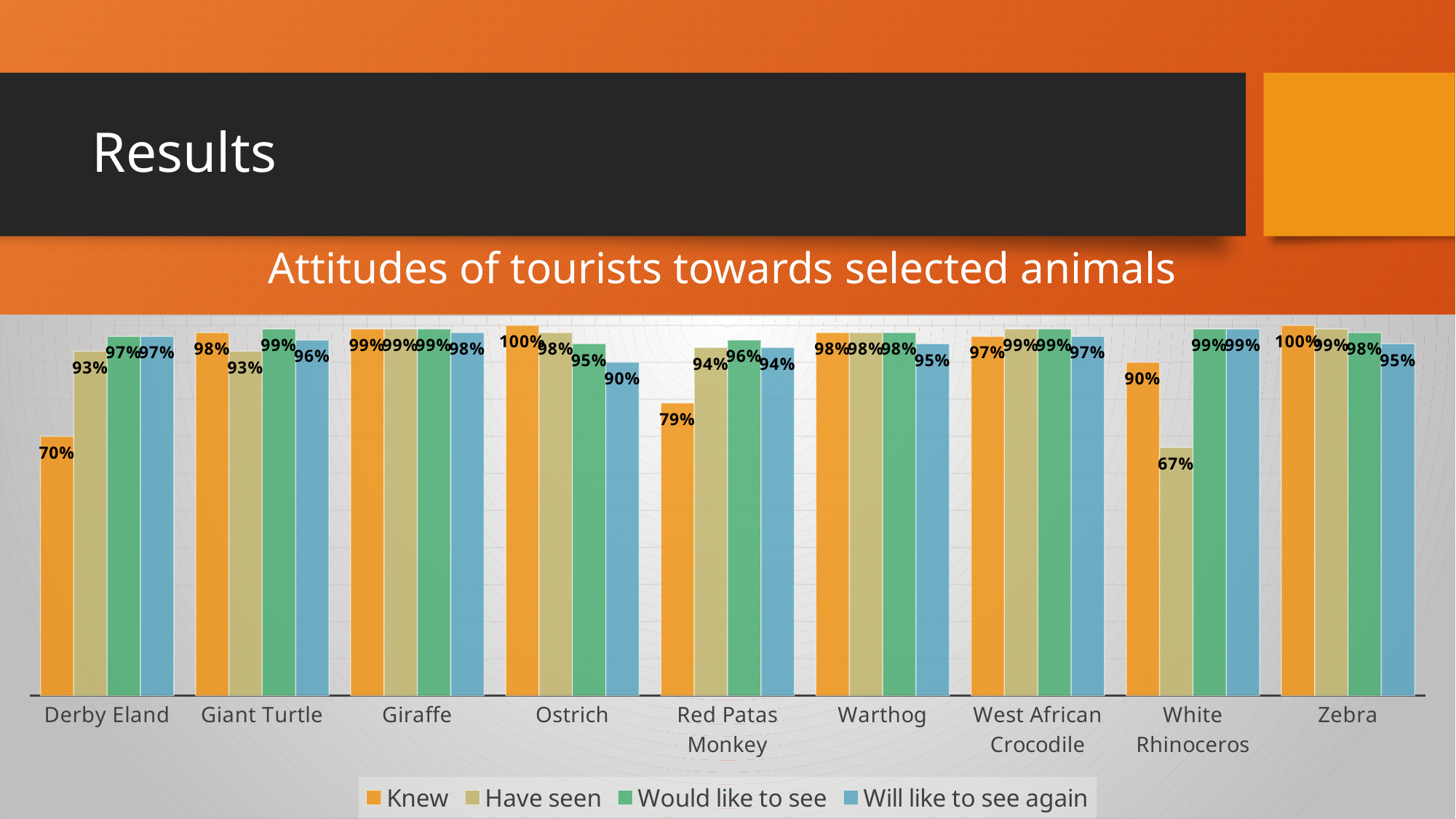
What percentage of tourists knew the Derby Eland? 70% Which is larger: the 'Knew' value for the Red Patas Monkey or the 'Knew' value for the Warthog? Warthog What is the 'Have seen' value for the White Rhinoceros? 67% How many animals are shown on the x axis? 9 Which animal has the lowest 'Knew' value? Derby Eland What is the 'Would like to see' value for the Red Patas Monkey? 96% What type of chart is shown on the slide? Bar chart What is the 'Will like to see again' value for the Ostrich? 90% What is the difference between the 'Would like to see' and 'Knew' values for the Derby Eland? 27 percentage points How many series does the legend list? 4 Which animal has the lowest 'Have seen' value? White Rhinoceros What is the difference between the 'Knew' and 'Have seen' values for the White Rhinoceros? 23 percentage points